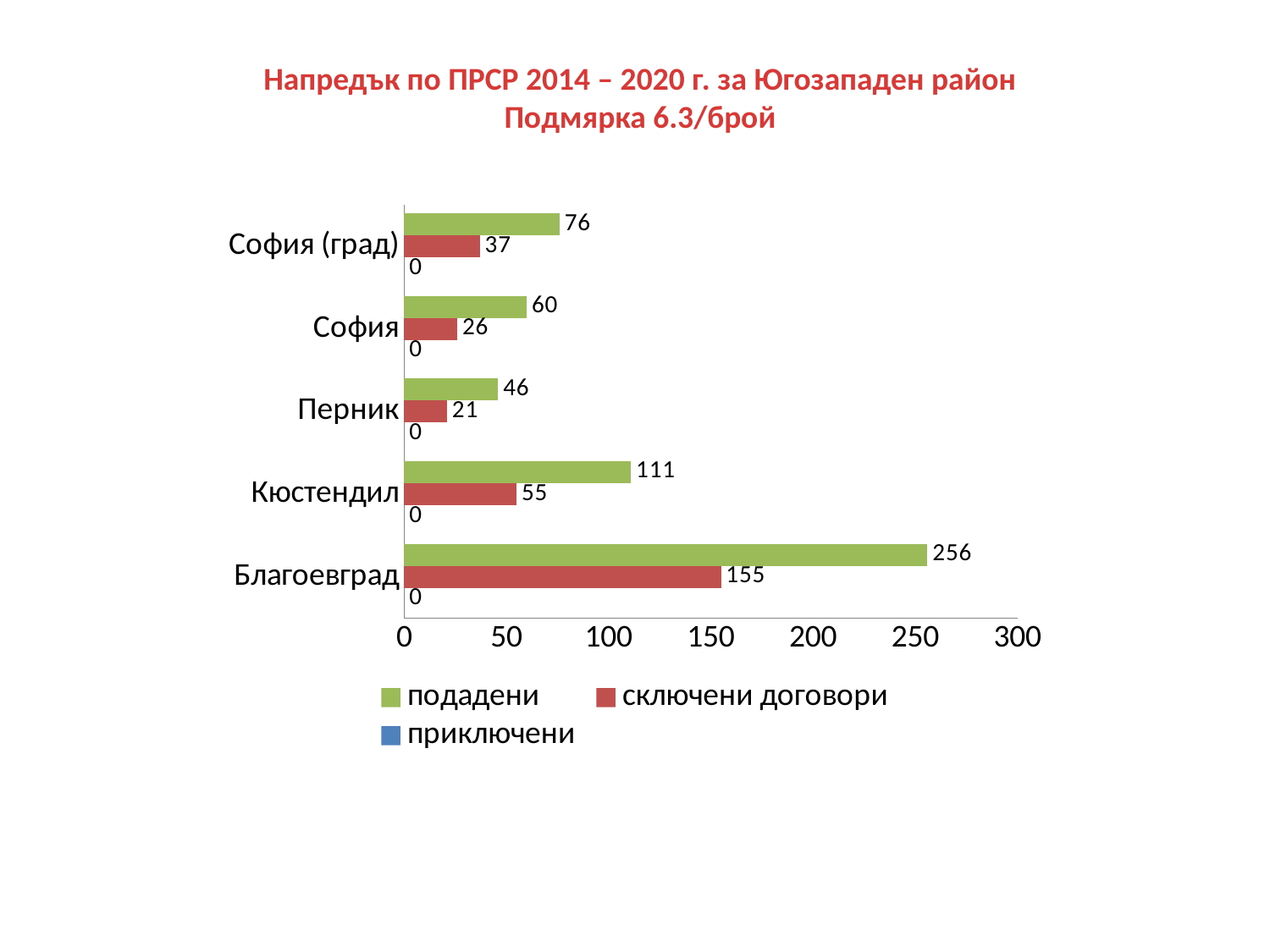
How many series does the legend list? 3 Which is larger: подадени for София (град) or подадени for София? София (град) What colour are the bars for сключени договори? red What is the difference between подадени and сключени договори for Благоевград? 101 What is the value of подадени for Перник? 46 What is the value of подадени for Благоевград? 256 Which category has the lowest value for сключени договори? Перник What kind of chart is shown on the slide? bar chart Which category has the highest value for подадени? Благоевград What is the value of приключени for София (град)? 0 How many categories are shown on the chart? 5 What is the value of сключени договори for Кюстендил? 55